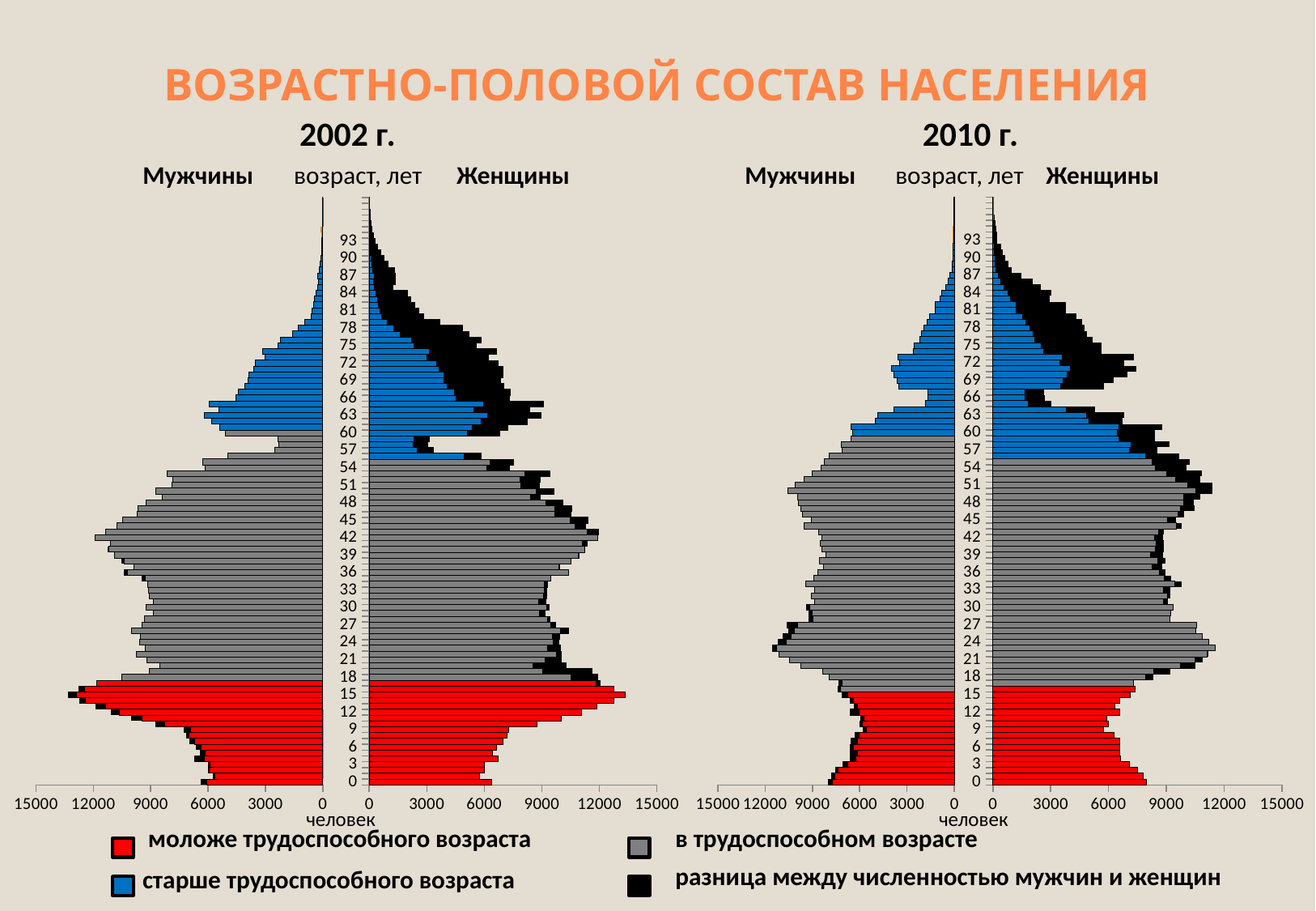
In the 2010 chart, is the value for women aged 93 greater or less than 3000? less In the 2002 chart, is the value for women aged 42 greater or less than 9000? greater What is the title of the slide? ВОЗРАСТНО-ПОЛОВОЙ СОСТАВ НАСЕЛЕНИЯ How many categories does the legend list? 4 In the 2010 chart, which is larger: the value for women aged 24 or the value for women aged 0? women aged 24 In the 2002 chart, is the value for men aged 42 greater or less than 9000? greater Which colour represents 'старше трудоспособного возраста' in the legend? blue In the 2002 chart, which is larger: the value for women aged 15 or the value for women aged 0? women aged 15 What kind of chart is used on this slide for the 2002 and 2010 population data? bar chart